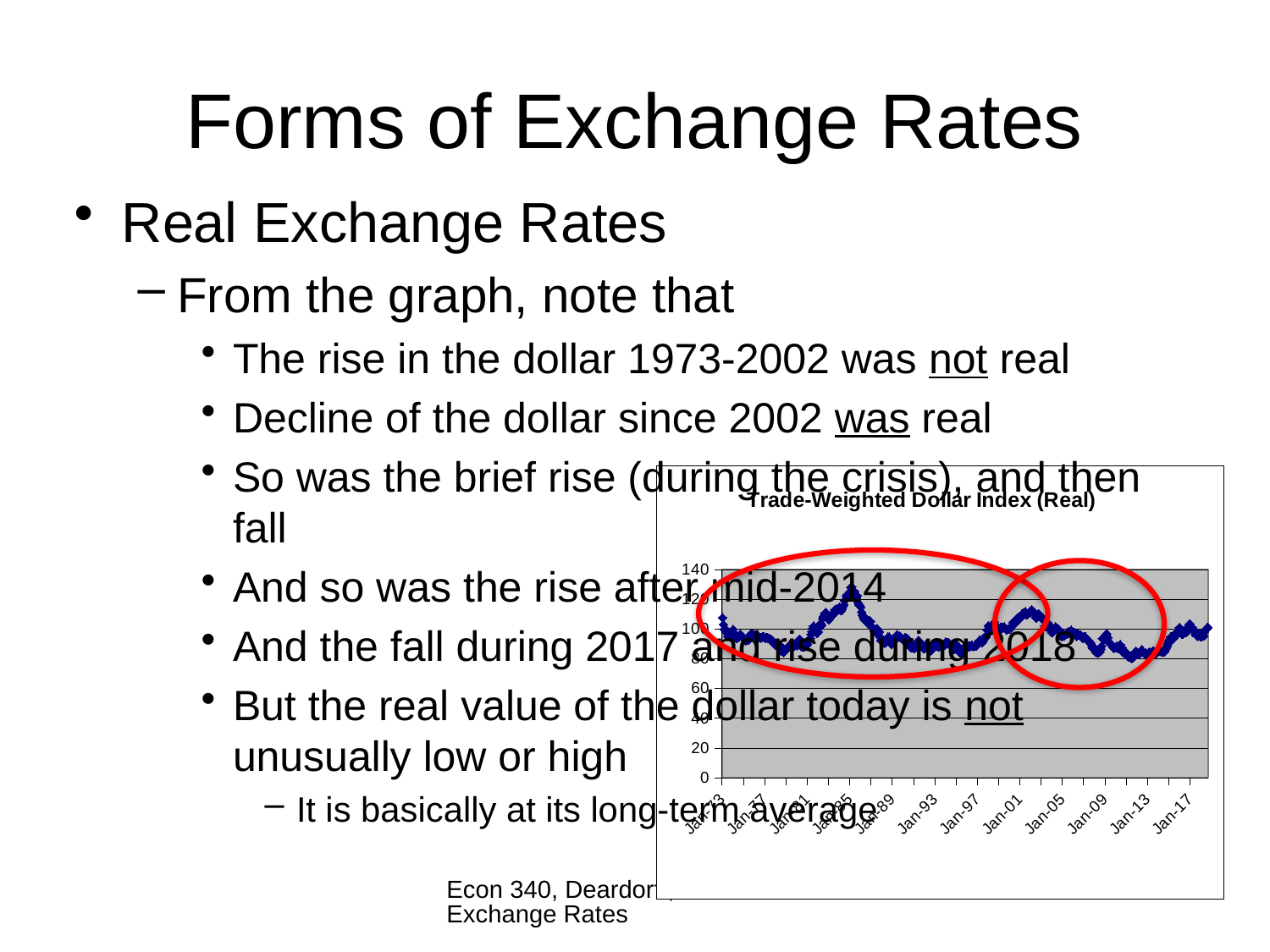
Near which horizontal-axis label does the Trade-Weighted Dollar Index reach its highest point? Jan-85 What is the highest value labelled on the chart's vertical axis? 140 How many date labels are shown along the chart's horizontal axis? 12 Is the value of the Trade-Weighted Dollar Index at Jan-13 greater or less than 100? less Is the value of the Trade-Weighted Dollar Index at Jan-85 greater or less than 100? greater What is the title of the chart on the slide? Trade-Weighted Dollar Index (Real) Does the Trade-Weighted Dollar Index rise or fall between Jan-85 and Jan-89? fall Is the value of the Trade-Weighted Dollar Index at Jan-01 greater or less than 100? greater Does the Trade-Weighted Dollar Index rise or fall between Jan-81 and Jan-85? rise What kind of chart is shown on the slide? line chart Which is larger, the Trade-Weighted Dollar Index at Jan-85 or at Jan-13? Jan-85